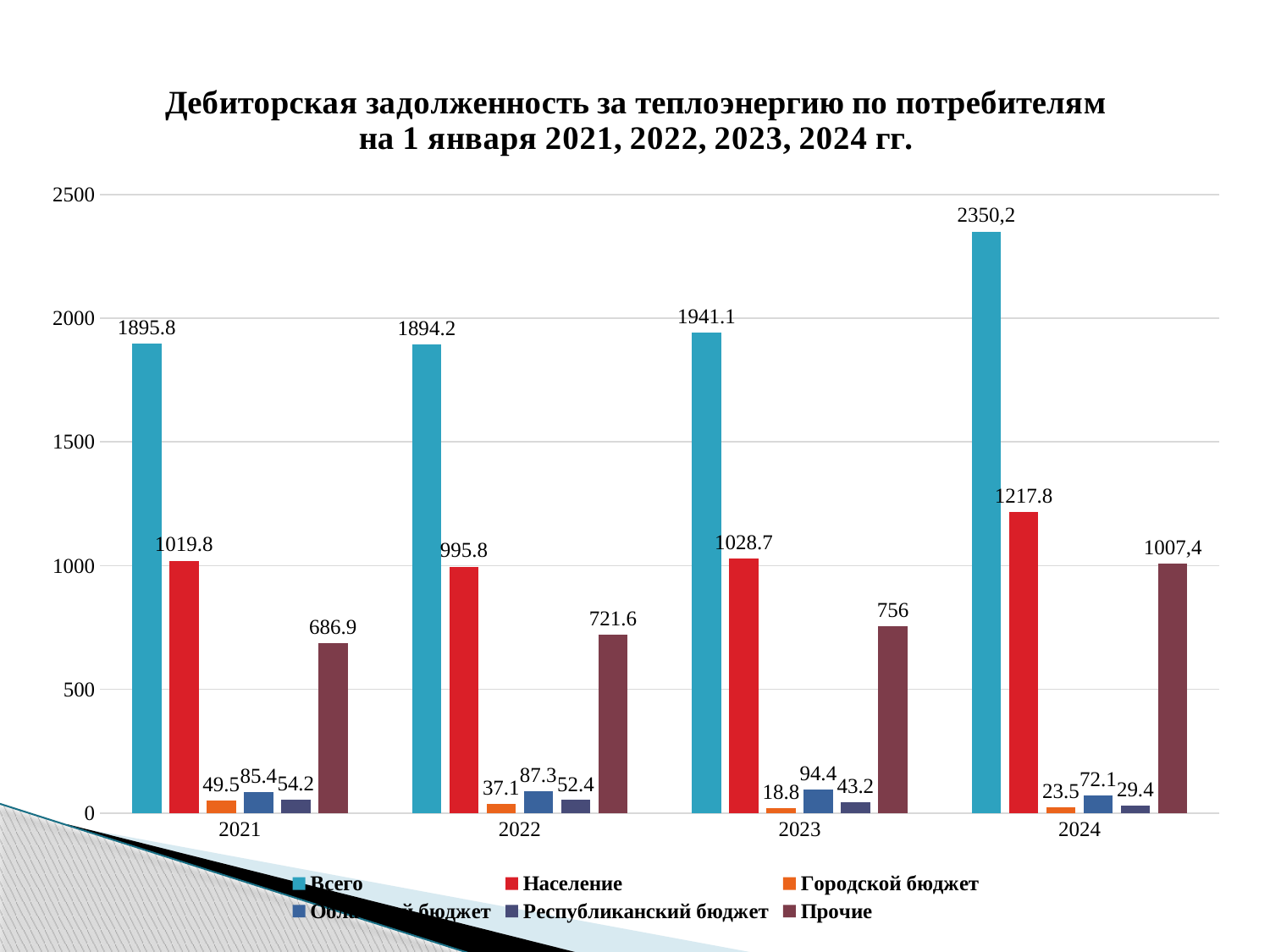
How many series does the legend list? 6 What kind of chart is shown on the slide? bar chart What is the difference between the Население values for 2024 and 2023? 189.1 How many years are shown on the x axis? 4 What is the value of Население for 2022? 995.8 What is the value of Республиканский бюджет for 2021? 54.2 Which year has the larger Прочие value, 2021 or 2022? 2022 What is the value of Всего for 2024? 2350,2 Is the value of Всего for 2023 greater or less than 2000? less In which year is the Всего value the highest? 2024 In which year is the Городской бюджет value the lowest? 2023 What is the value of Прочие for 2023? 756